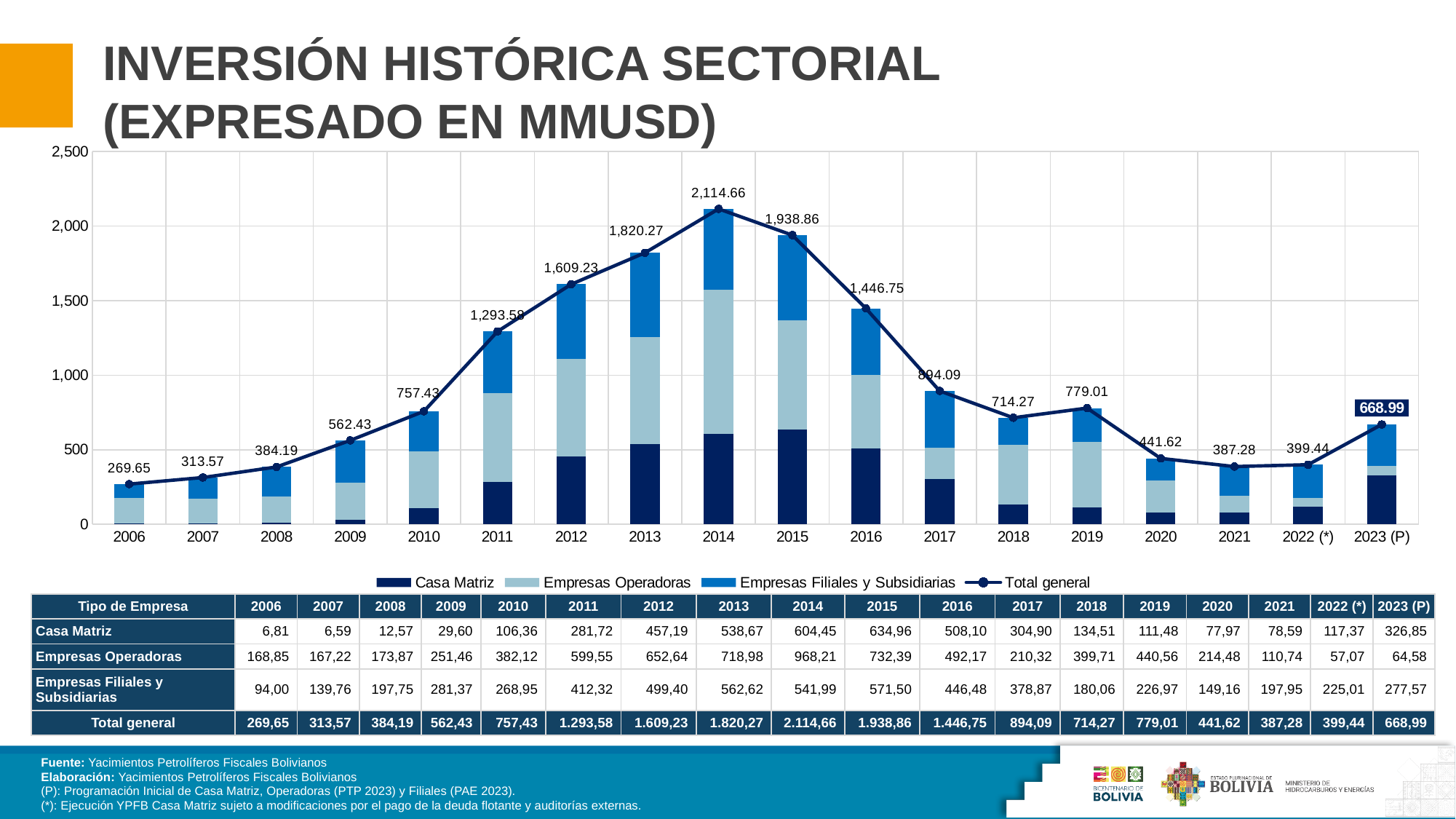
What is the difference between the Total general for 2014 and for 2015? 175.80 Which year has the highest Total general? 2014 What is the Empresas Filiales y Subsidiarias value for 2023 (P)? 277,57 Which year has the lowest Total general? 2006 Which year has the larger Total general, 2018 or 2019? 2019 Does the Total general rise or fall from 2006 to 2014? rise Is the Total general for 2011 greater or less than 1,000? greater How many series does the legend list? 4 How many years are shown on the x axis? 18 What kind of chart is shown on the slide? stacked bar chart with a line What is the Casa Matriz value for 2015? 634,96 What is the Total general value for 2014? 2,114.66